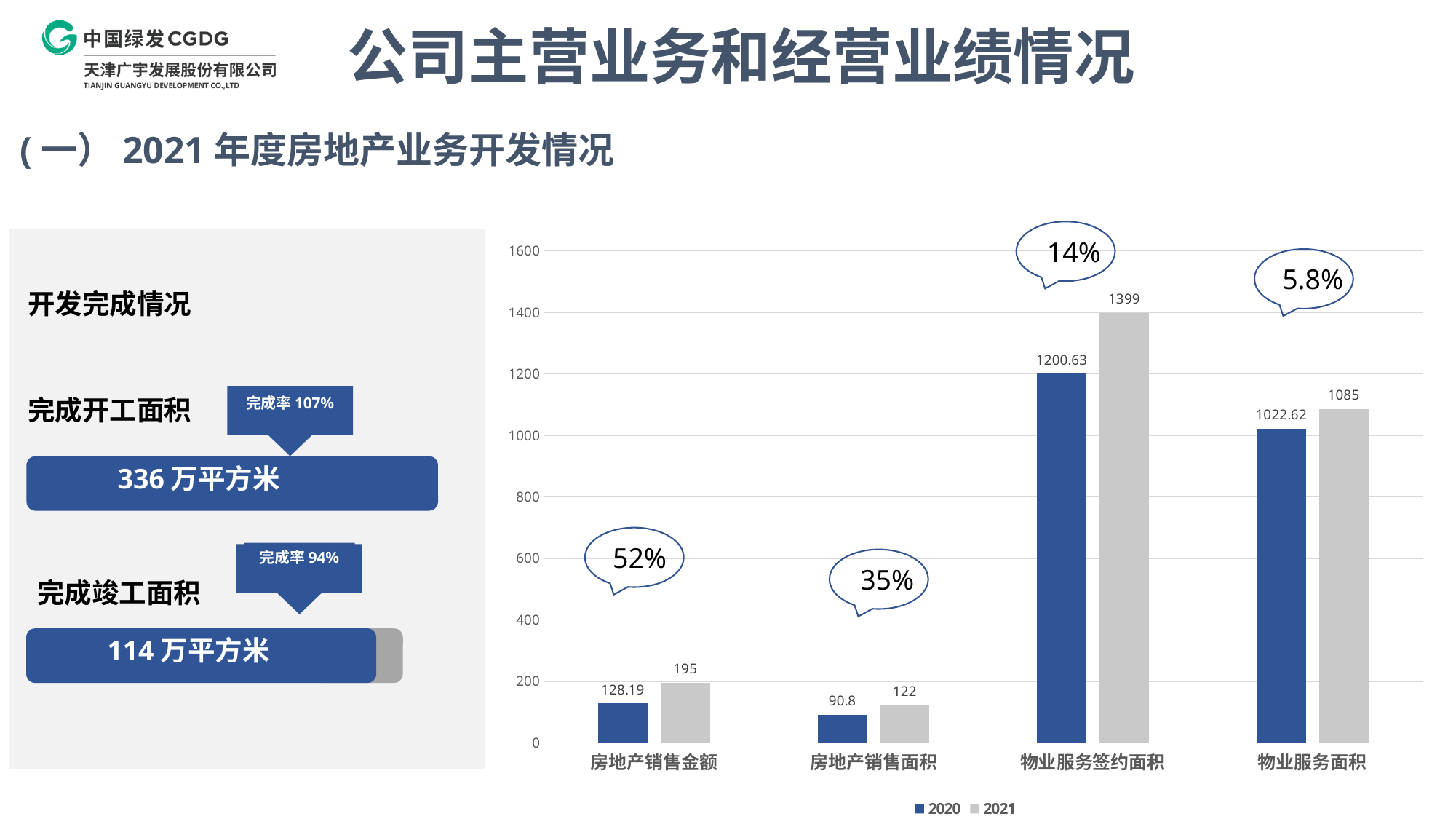
Which category has the lowest 2020 value? 房地产销售面积 What is the 2020 value for 房地产销售金额? 128.19 How many categories are shown on the x axis of the chart? 4 What is the difference between the 2021 and 2020 values for 房地产销售面积? 31.2 Which is larger: the 2021 value for 物业服务面积 or the 2020 value for 物业服务签约面积? 2020 value for 物业服务签约面积 Which category has the highest 2021 value? 物业服务签约面积 What is the 2020 value for 物业服务面积? 1022.62 How many series does the chart legend list? 2 What is the 2021 value for 物业服务签约面积? 1399 What percentage is shown in the callout above 物业服务面积? 5.8% What is the 2021 value for 房地产销售面积? 122 What type of chart is shown on the slide? bar chart